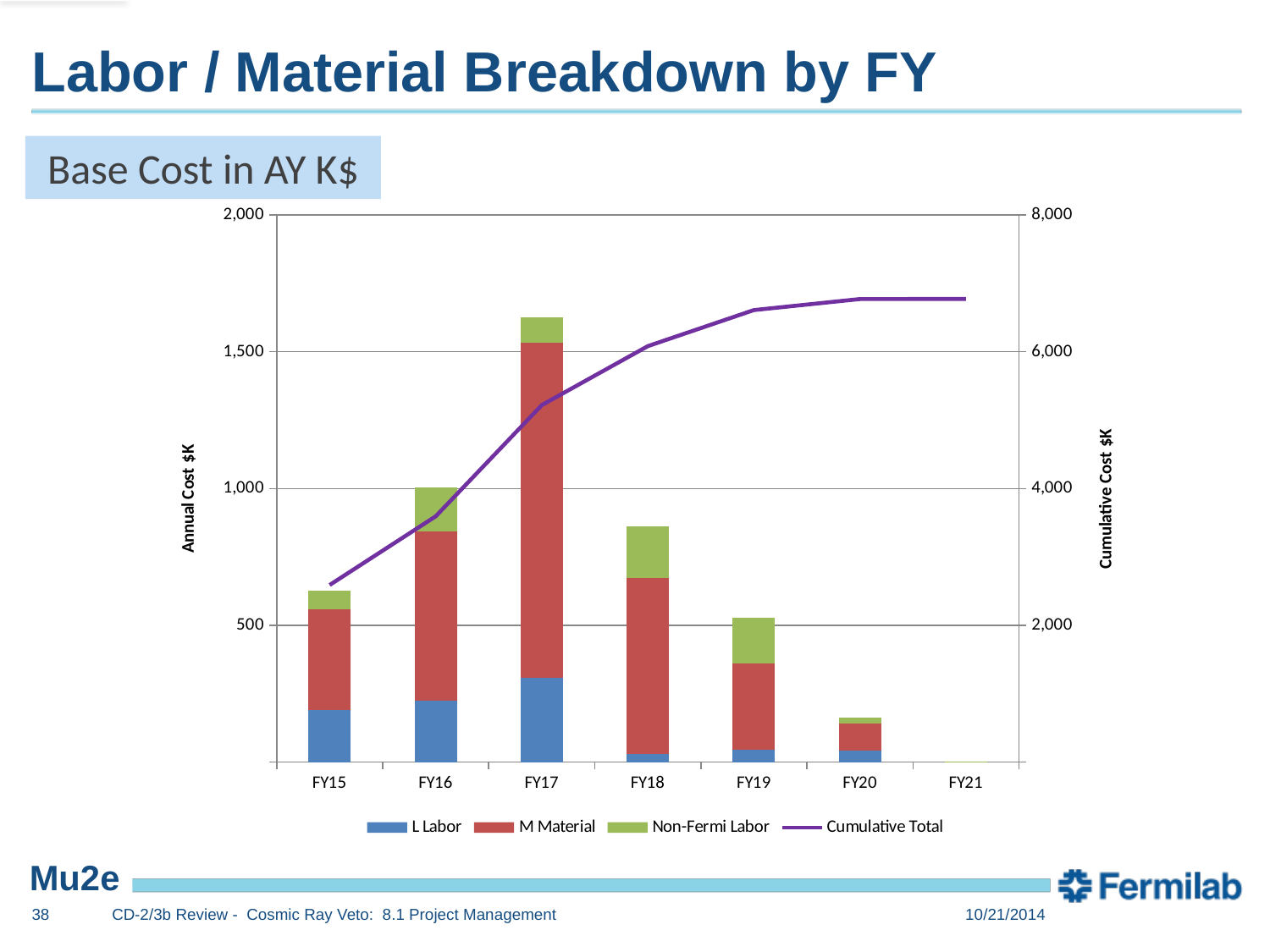
Is the total annual cost for FY20 greater or less than 500? less Which has the larger total annual cost, FY17 or FY18? FY17 Is the total annual cost for FY18 greater or less than 1,000? less Which fiscal year has the tallest stacked bar? FY17 Is the Cumulative Total at FY21 greater or less than 6,000? greater Which fiscal year has the lowest annual cost? FY21 Does the Cumulative Total line rise or fall from FY15 to FY21? rise What kind of chart is shown on the slide? A stacked bar chart with a line How many series does the legend list? 4 What is the label of the right-hand vertical axis? Cumulative Cost $K How many fiscal years are shown on the x axis? 7